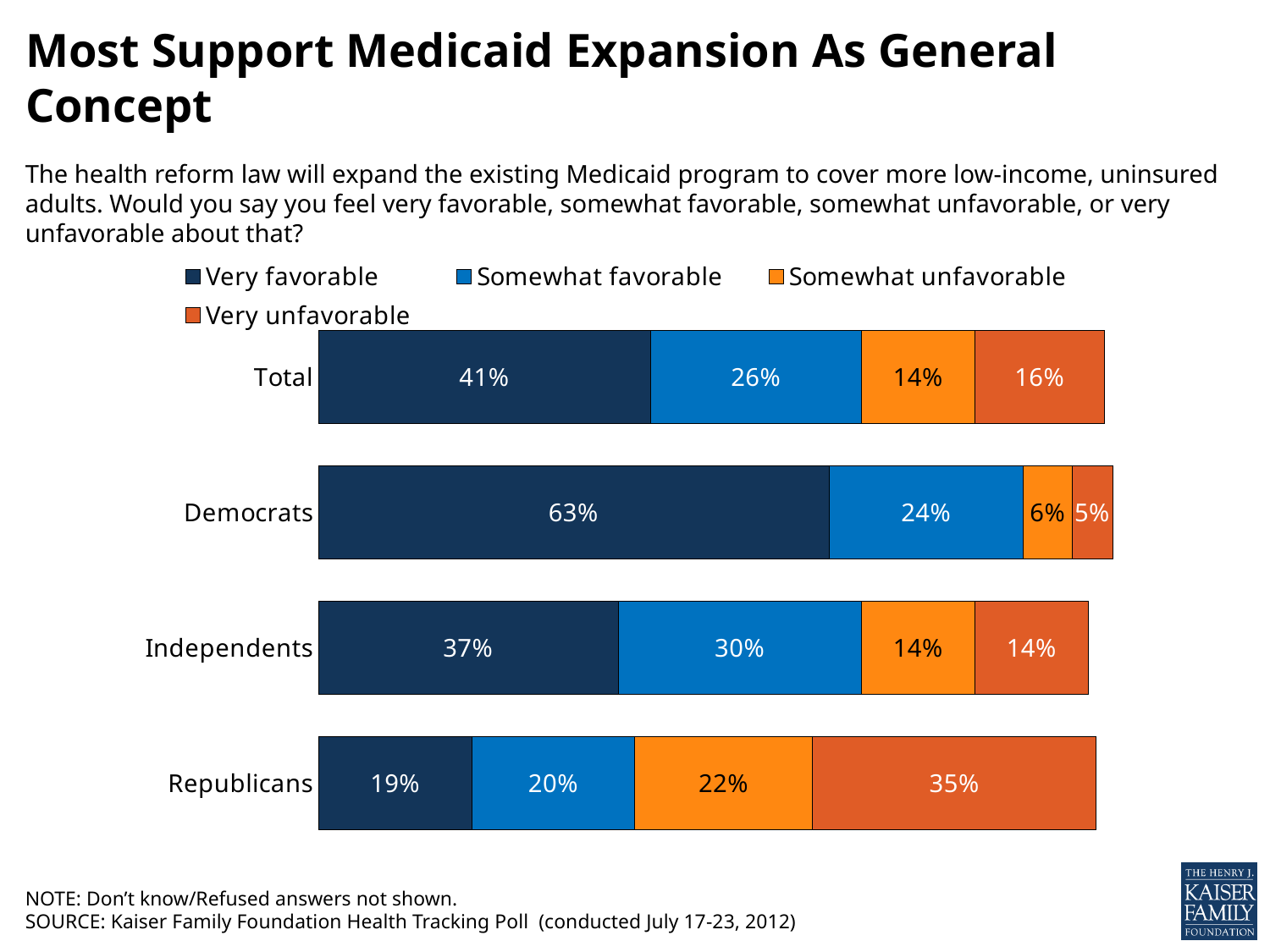
How many series does the legend list? 4 What percentage of Republicans are very unfavorable toward the Medicaid expansion? 35% What is the Somewhat favorable value for Independents? 30% What is the difference between the Very favorable percentages for Democrats and Republicans? 44 percentage points Which is larger: the Somewhat unfavorable value for Republicans or for Independents? Republicans What is the combined total of Very favorable and Somewhat favorable for the Total group? 67% What percentage of Democrats are very favorable toward the Medicaid expansion? 63% Which group has the highest Very favorable percentage? Democrats How many groups (bars) are shown in the chart? 4 What is the Somewhat unfavorable value for the Total group? 14% Which group has the lowest Very favorable percentage? Republicans What kind of chart is shown on the slide? Stacked bar chart